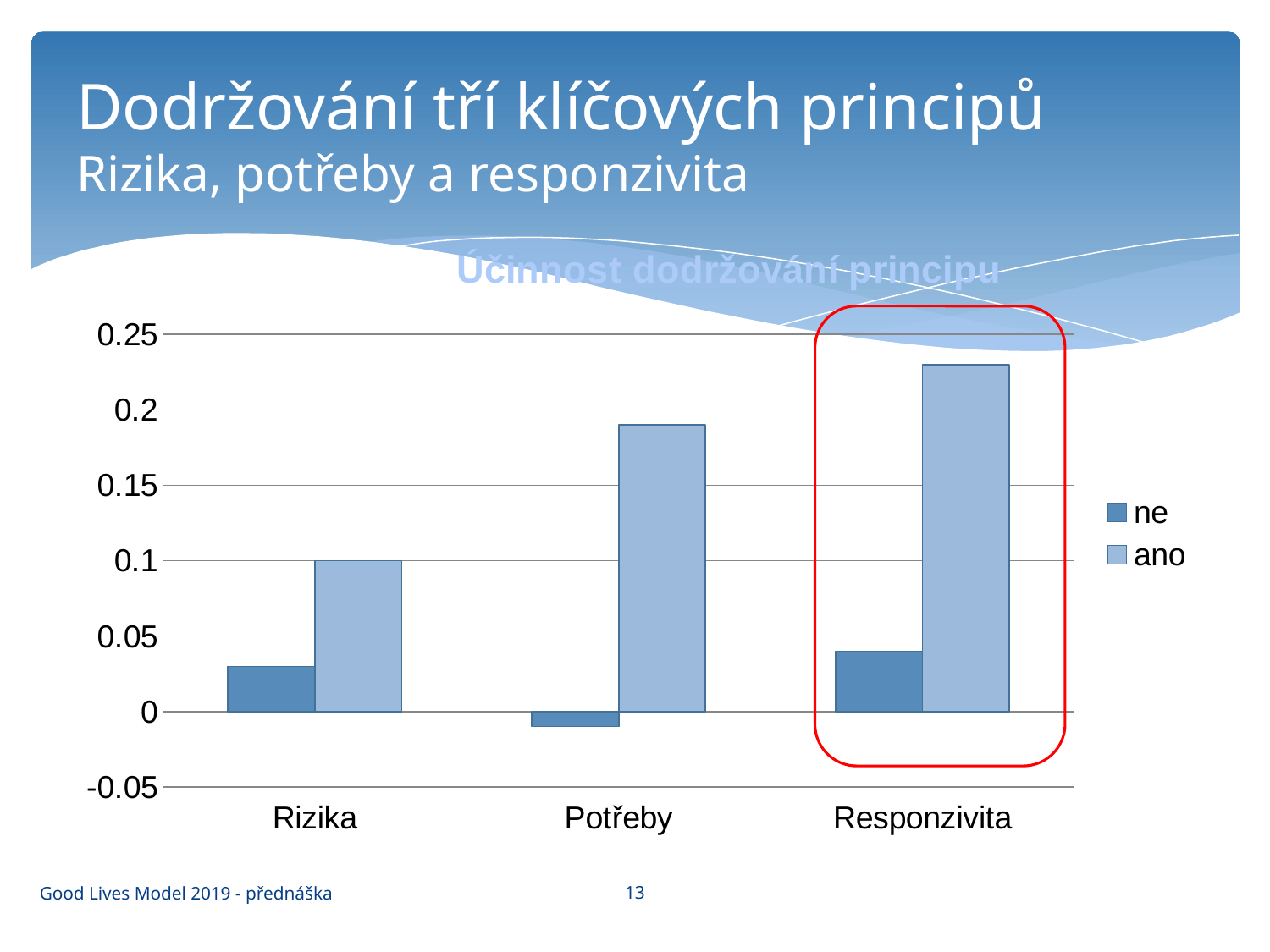
What is the value of the 'ano' bar for Rizika? 0.1 What are the two series named in the chart's legend? ne and ano How many series does the chart's legend list? 2 Which is larger: the 'ano' bar for Potřeby or the 'ano' bar for Rizika? Potřeby What is the title of the chart? Účinnost dodržování principu Which category has the highest 'ano' bar? Responzivita Is the 'ano' value for Responzivita greater or less than 0.2? greater How many categories are shown on the x axis of the chart? 3 Do the 'ano' values rise or fall from Rizika to Responzivita along the x axis? rise Is the 'ne' value for Potřeby greater or less than 0? less Which category has the lowest 'ne' bar? Potřeby What kind of chart is shown on the slide? bar chart